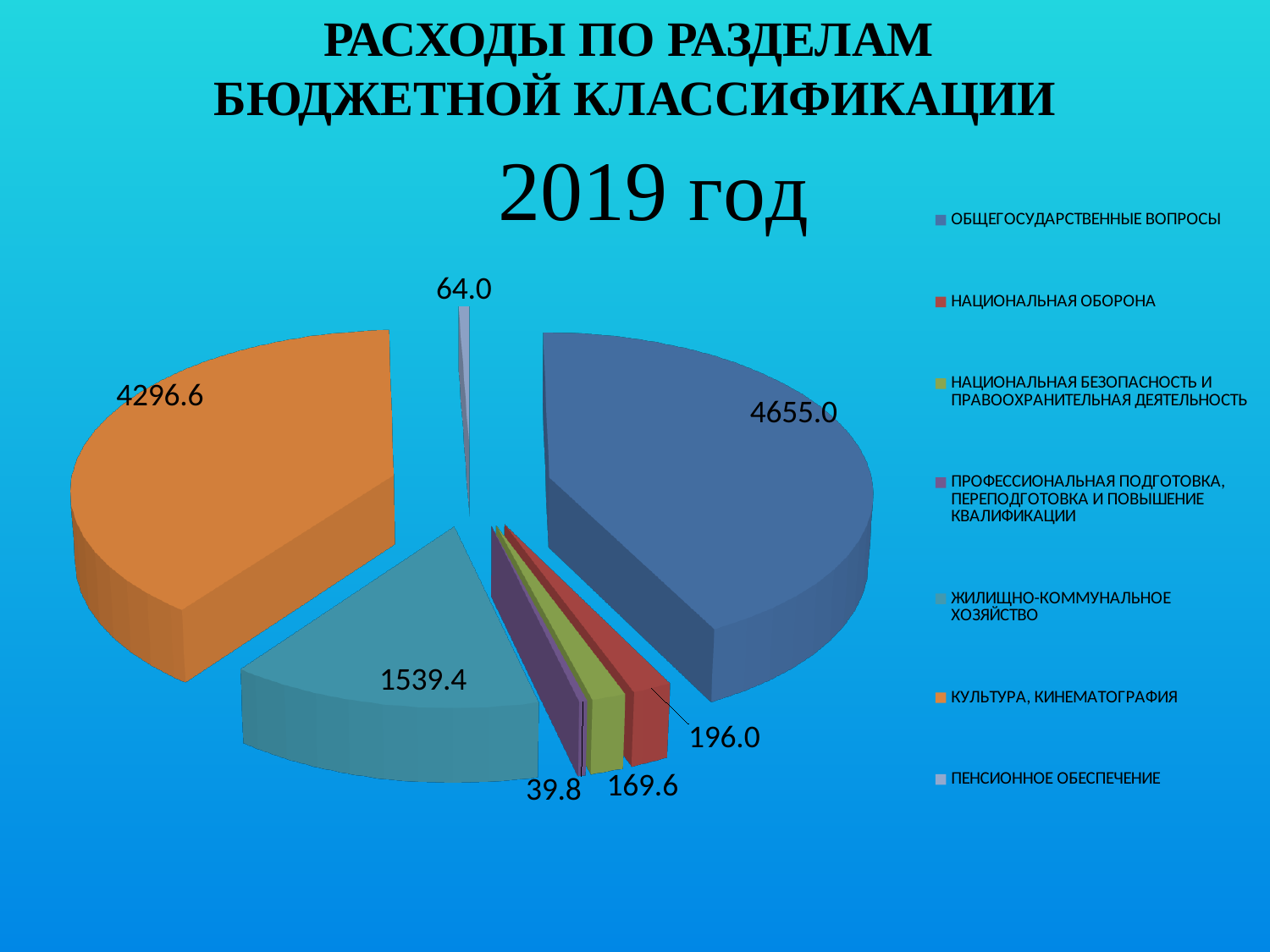
Which year does the chart title refer to? 2019 год How many categories does the legend list? 7 What type of chart is shown on the slide? Pie chart What is the value for ОБЩЕГОСУДАРСТВЕННЫЕ ВОПРОСЫ? 4655.0 What is the value for КУЛЬТУРА, КИНЕМАТОГРАФИЯ? 4296.6 What is the difference between the values for ОБЩЕГОСУДАРСТВЕННЫЕ ВОПРОСЫ and КУЛЬТУРА, КИНЕМАТОГРАФИЯ? 358.4 What is the value for ПЕНСИОННОЕ ОБЕСПЕЧЕНИЕ? 64.0 Which category has the smallest value? ПРОФЕССИОНАЛЬНАЯ ПОДГОТОВКА, ПЕРЕПОДГОТОВКА И ПОВЫШЕНИЕ КВАЛИФИКАЦИИ What is the value for ЖИЛИЩНО-КОММУНАЛЬНОЕ ХОЗЯЙСТВО? 1539.4 Which is larger: НАЦИОНАЛЬНАЯ ОБОРОНА or НАЦИОНАЛЬНАЯ БЕЗОПАСНОСТЬ И ПРАВООХРАНИТЕЛЬНАЯ ДЕЯТЕЛЬНОСТЬ? НАЦИОНАЛЬНАЯ ОБОРОНА What is the value for НАЦИОНАЛЬНАЯ ОБОРОНА? 196.0 Which category has the largest value? ОБЩЕГОСУДАРСТВЕННЫЕ ВОПРОСЫ